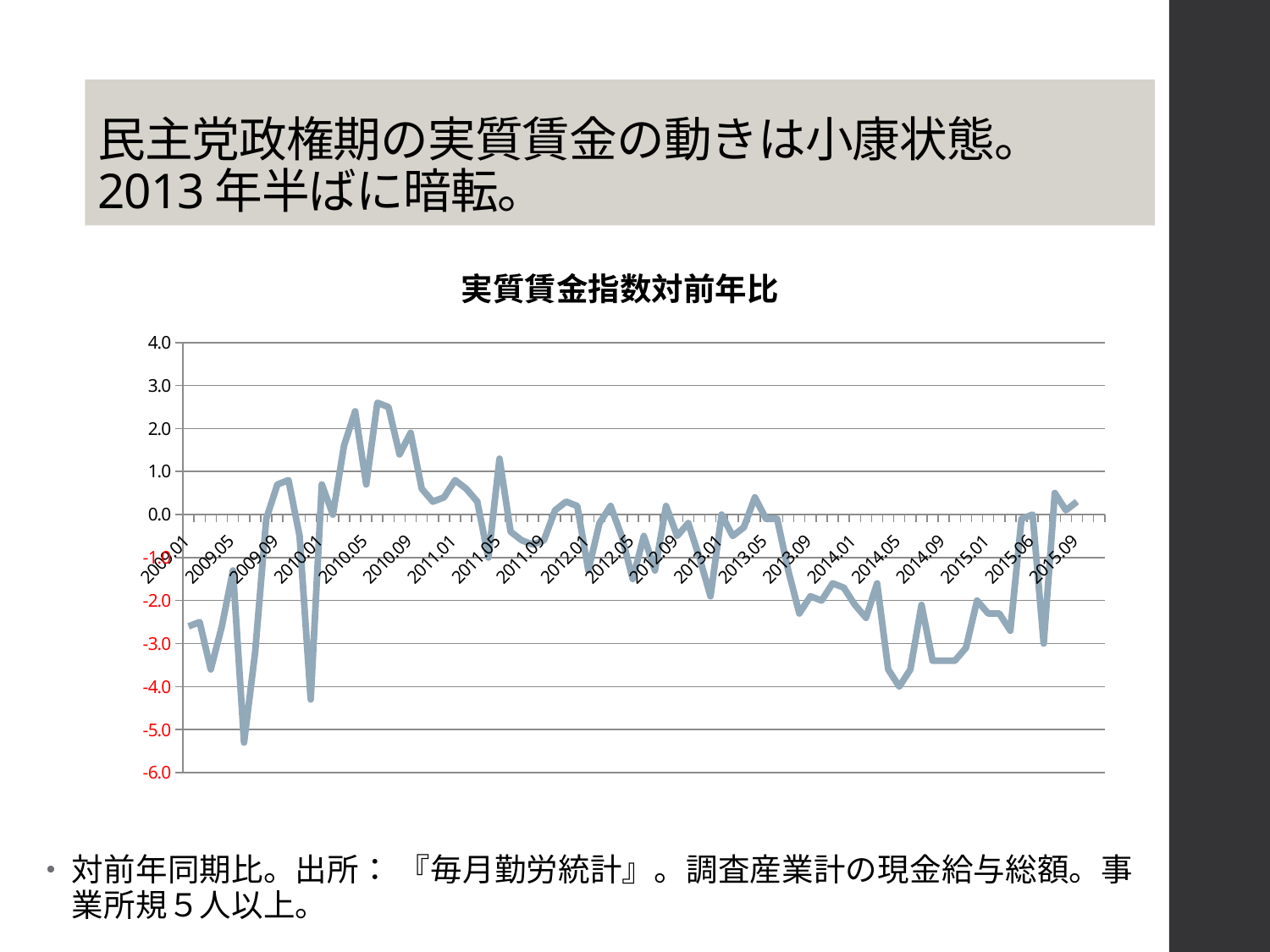
What is the highest value shown on the vertical axis of the chart? 4.0 What is the title of the chart? 実質賃金指数対前年比 Is the value for 2009.01 greater or less than -2.0? less Is the lowest point of the line, near 2009.09, greater or less than -5.0? less What kind of chart is shown on the slide? line chart Is the value for 2014.09 greater or less than -3.0? less How many date labels are printed along the x axis? 21 Which period has the higher value, 2010.05 or 2014.05? 2010.05 Do the values generally rise or fall between 2013.05 and 2014.05? fall